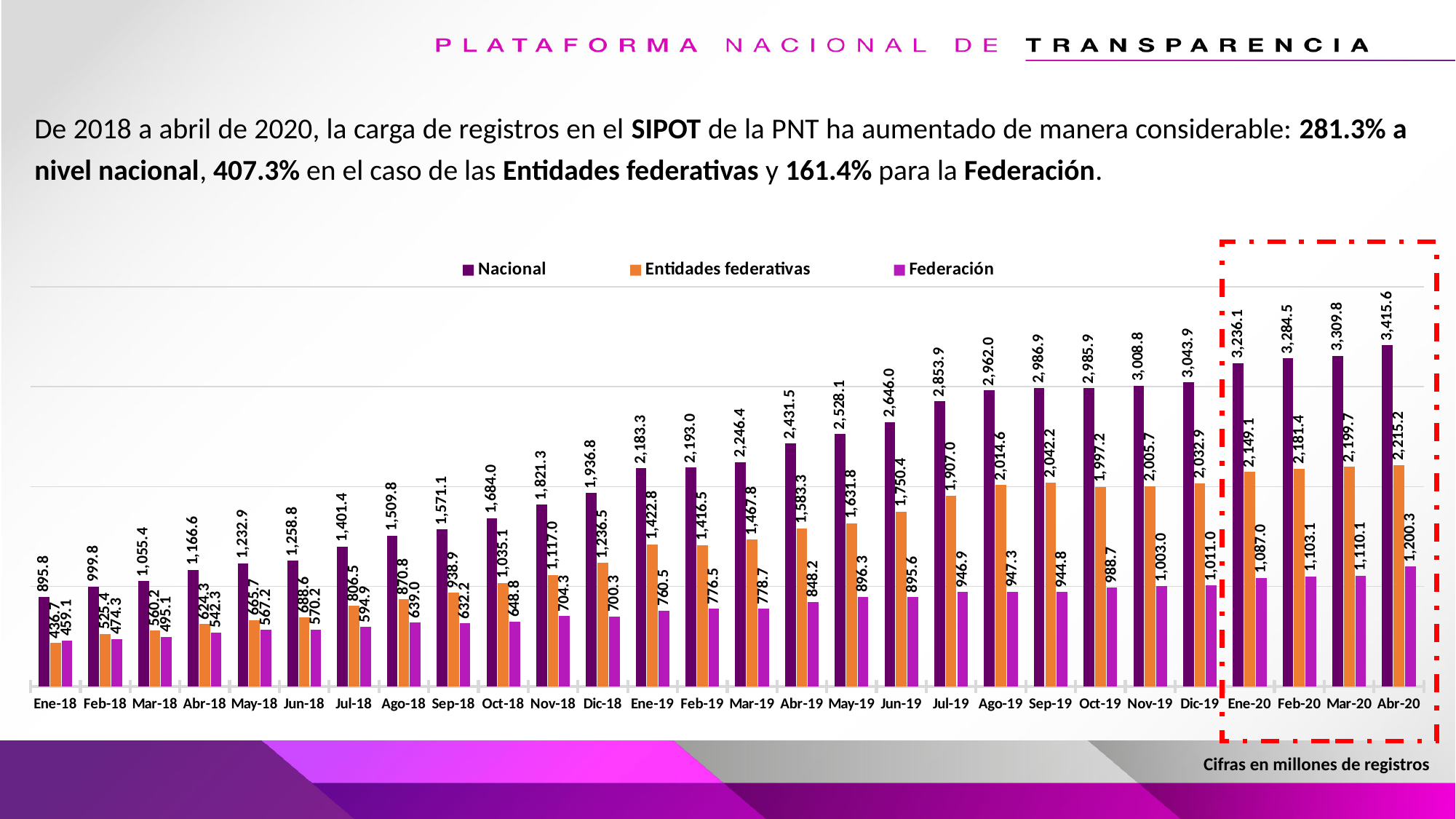
By how much did the Nacional value increase from Ene-18 to Abr-20? 2,519.8 In which month is the Nacional value highest? Abr-20 What is the difference between the Federación values for Abr-20 and Mar-20? 90.2 How many months are shown on the x axis? 28 In Ene-18, which is larger: Entidades federativas or Federación? Federación How many series does the legend list? 3 What is the Entidades federativas value for Dic-19? 2,032.9 What kind of chart is shown on the slide? Bar chart Does the Nacional series generally rise or fall from Ene-18 to Abr-20? Rise In which month is the Entidades federativas value lowest? Ene-18 What is the Nacional value for Abr-20? 3,415.6 What is the Federación value for Ene-18? 459.1